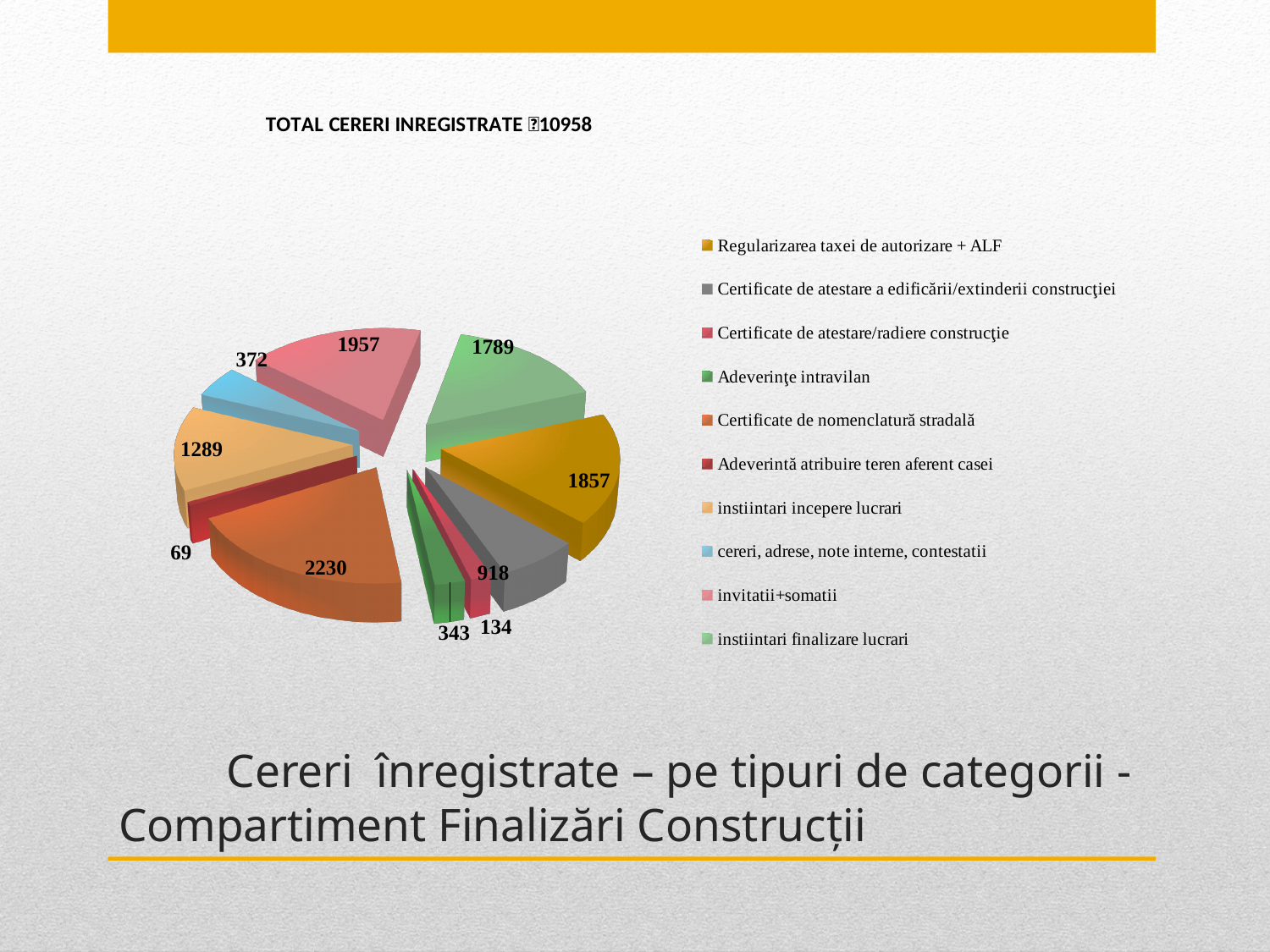
Which category has the smallest slice? Adeverintă atribuire teren aferent casei What total number of registered requests is stated above the chart? 10958 What is the value for Regularizarea taxei de autorizare + ALF? 1857 Which category has the largest slice? Certificate de nomenclatură stradală How many entries does the legend list? 10 How many slices does the pie chart have? 10 What is the value for Adeverintă atribuire teren aferent casei? 69 What type of chart is shown on the slide? pie chart What is the value for invitatii+somatii? 1957 What is the difference between the values for invitatii+somatii and instiintari finalizare lucrari? 168 Which is larger: instiintari incepere lucrari or Certificate de atestare a edificării/extinderii construcţiei? instiintari incepere lucrari What is the value for Certificate de nomenclatură stradală? 2230